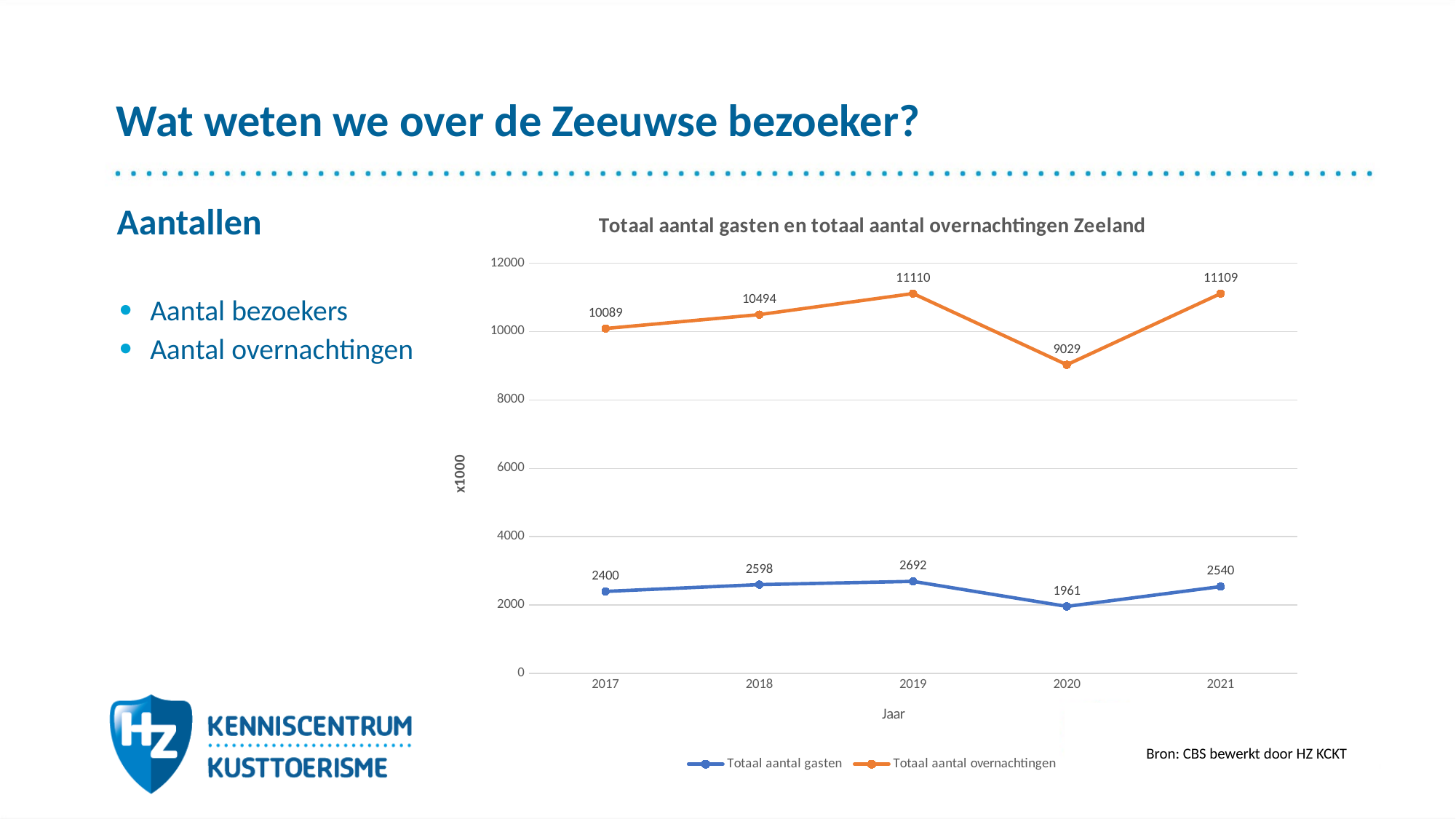
In which year is Totaal aantal overnachtingen lowest? 2020 In which year is Totaal aantal gasten highest? 2019 What is the value for Totaal aantal gasten in 2019? 2692 What is the difference between Totaal aantal overnachtingen in 2019 and 2020? 2081 What is the value for Totaal aantal overnachtingen in 2020? 9029 Which is larger: Totaal aantal gasten in 2021 or in 2017? 2021 How many years are shown on the x axis? 5 What is the difference between Totaal aantal gasten in 2018 and 2017? 198 How many series does the legend list? 2 What is the value for Totaal aantal overnachtingen in 2017? 10089 In which year is Totaal aantal gasten lowest? 2020 What kind of chart is shown? Line chart